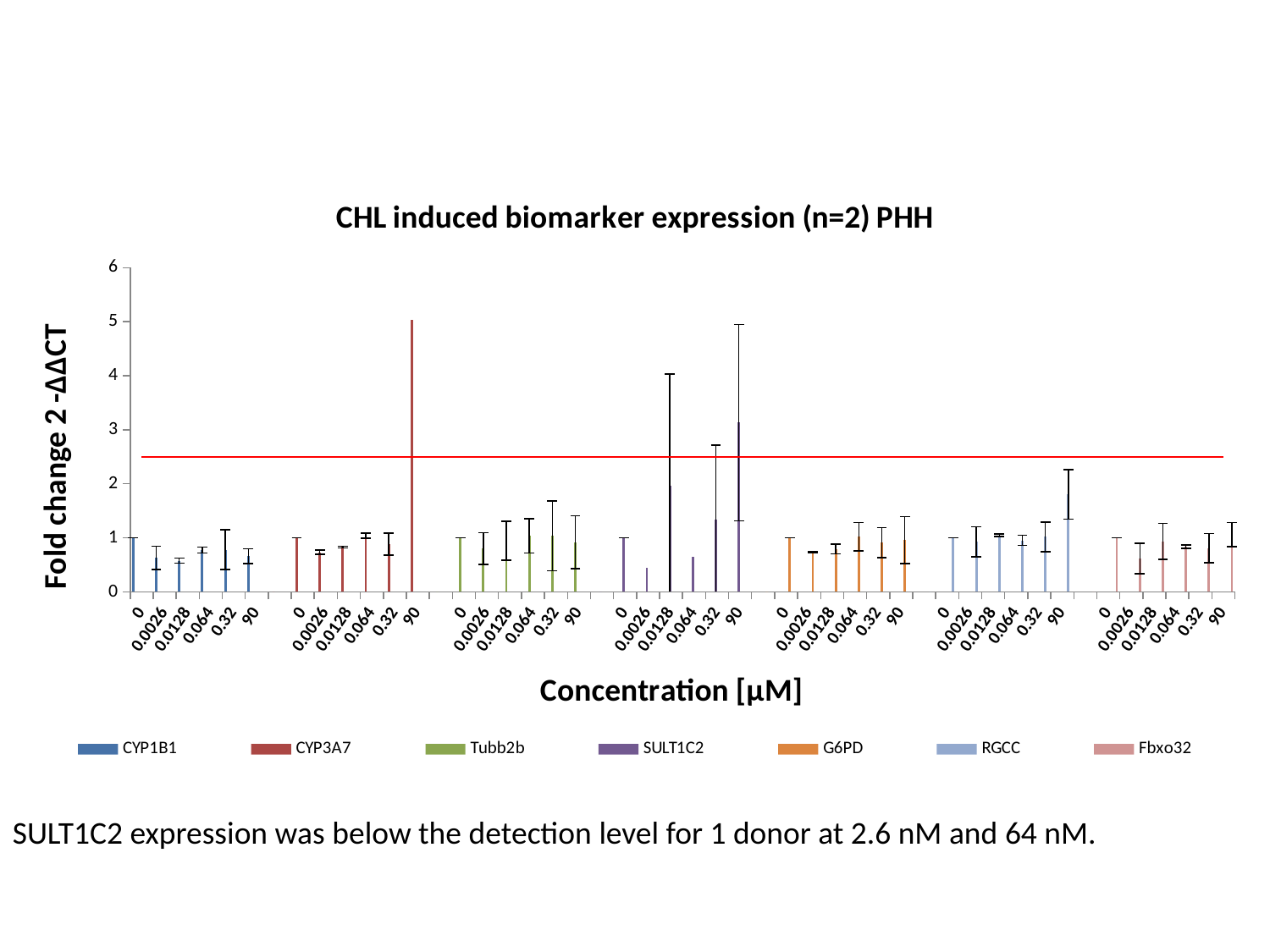
Which series has the tallest bar in the chart? CYP3A7 How many series does the legend list? 7 What kind of chart is shown on the slide? bar chart Which is larger: the value for CYP3A7 at concentration 90 or the value for SULT1C2 at concentration 0.0128? CYP3A7 at 90 Is the value for CYP1B1 at concentration 0.0128 greater or less than 1? less Is the value for RGCC at concentration 90 greater or less than 1? greater Is the value for SULT1C2 at concentration 0.0128 greater or less than 1? greater What is the label of the x axis? Concentration [µM] What is the title of the chart? CHL induced biomarker expression (n=2) PHH How many concentration categories are plotted for each series? 6